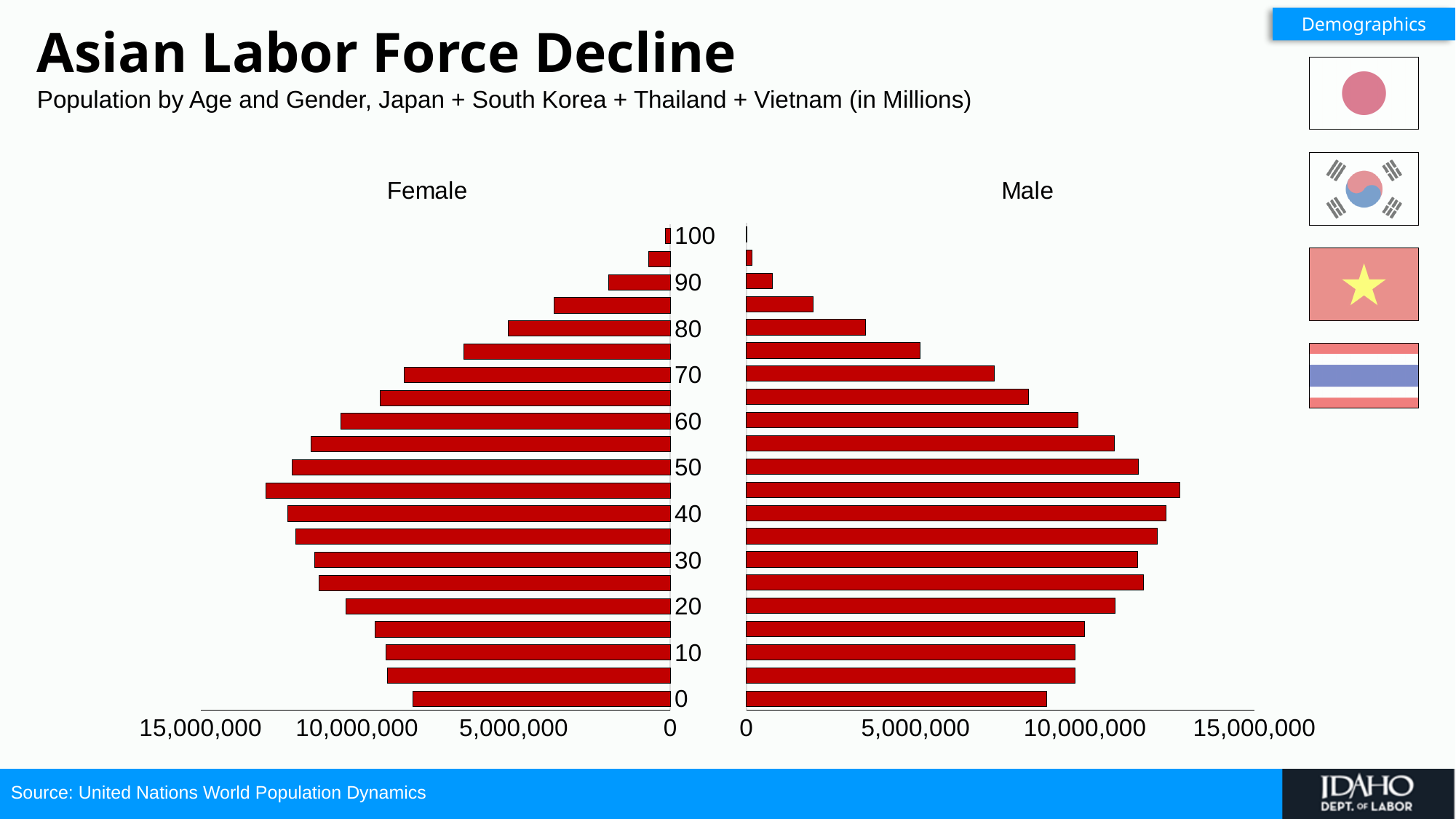
What are the two panels of the chart labelled? Female and Male What is the title of the chart on the slide? Asian Labor Force Decline In the Female panel, which age group has the longest bar? 45 In the Male panel, is the value for age 80 greater or less than 5,000,000? less What kind of chart is shown on the slide? Bar chart In the Female panel, which age group has the shortest bar? 100 In the Male panel, do the bars get shorter or longer as age increases from 50 to 100? shorter In the Male panel, which is larger, the value for age 45 or the value for age 85? 45 In the Female panel, is the value for age 70 greater or less than 5,000,000? greater In the Male panel, which age group has the longest bar? 45 In the Female panel, is the value for age 45 greater or less than 10,000,000? greater